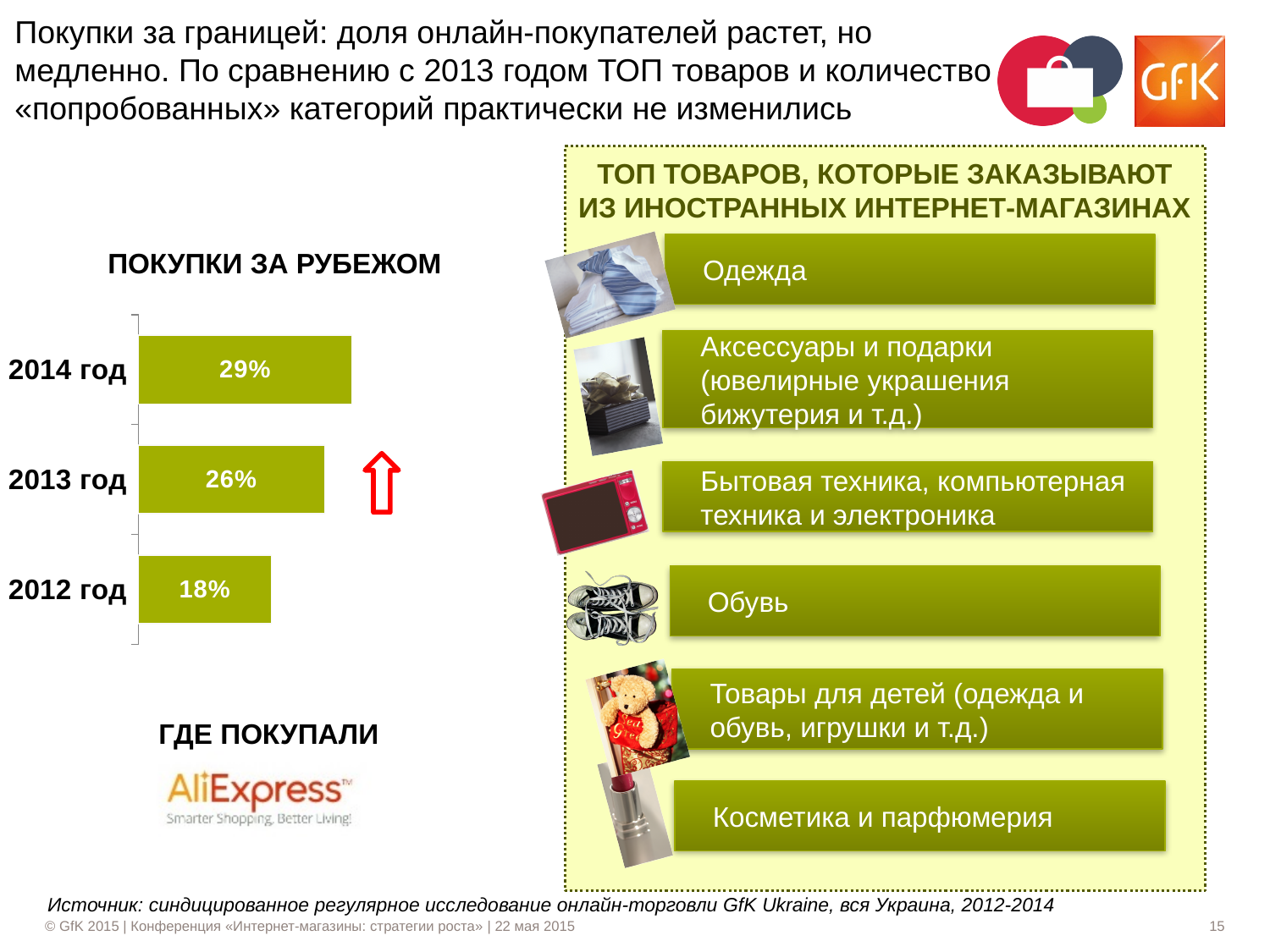
What is the title of the bar chart on the left of the slide? ПОКУПКИ ЗА РУБЕЖОМ Which year has the highest value in the ПОКУПКИ ЗА РУБЕЖОМ chart? 2014 год What is the value for 2013 год in the ПОКУПКИ ЗА РУБЕЖОМ chart? 26% What is the value for 2014 год in the ПОКУПКИ ЗА РУБЕЖОМ chart? 29% What is the value for 2012 год in the ПОКУПКИ ЗА РУБЕЖОМ chart? 18% Which year has the lowest value in the ПОКУПКИ ЗА РУБЕЖОМ chart? 2012 год What kind of chart is the ПОКУПКИ ЗА РУБЕЖОМ chart? Bar chart What is the difference between the values for 2013 год and 2012 год in the ПОКУПКИ ЗА РУБЕЖОМ chart? 8% Do the values in the ПОКУПКИ ЗА РУБЕЖОМ chart rise or fall from 2012 год to 2014 год? Rise How many years are shown in the ПОКУПКИ ЗА РУБЕЖОМ chart? 3 In the ПОКУПКИ ЗА РУБЕЖОМ chart, which is larger: the value for 2012 год or 2013 год? 2013 год What is the difference between the values for 2014 год and 2013 год in the ПОКУПКИ ЗА РУБЕЖОМ chart? 3%